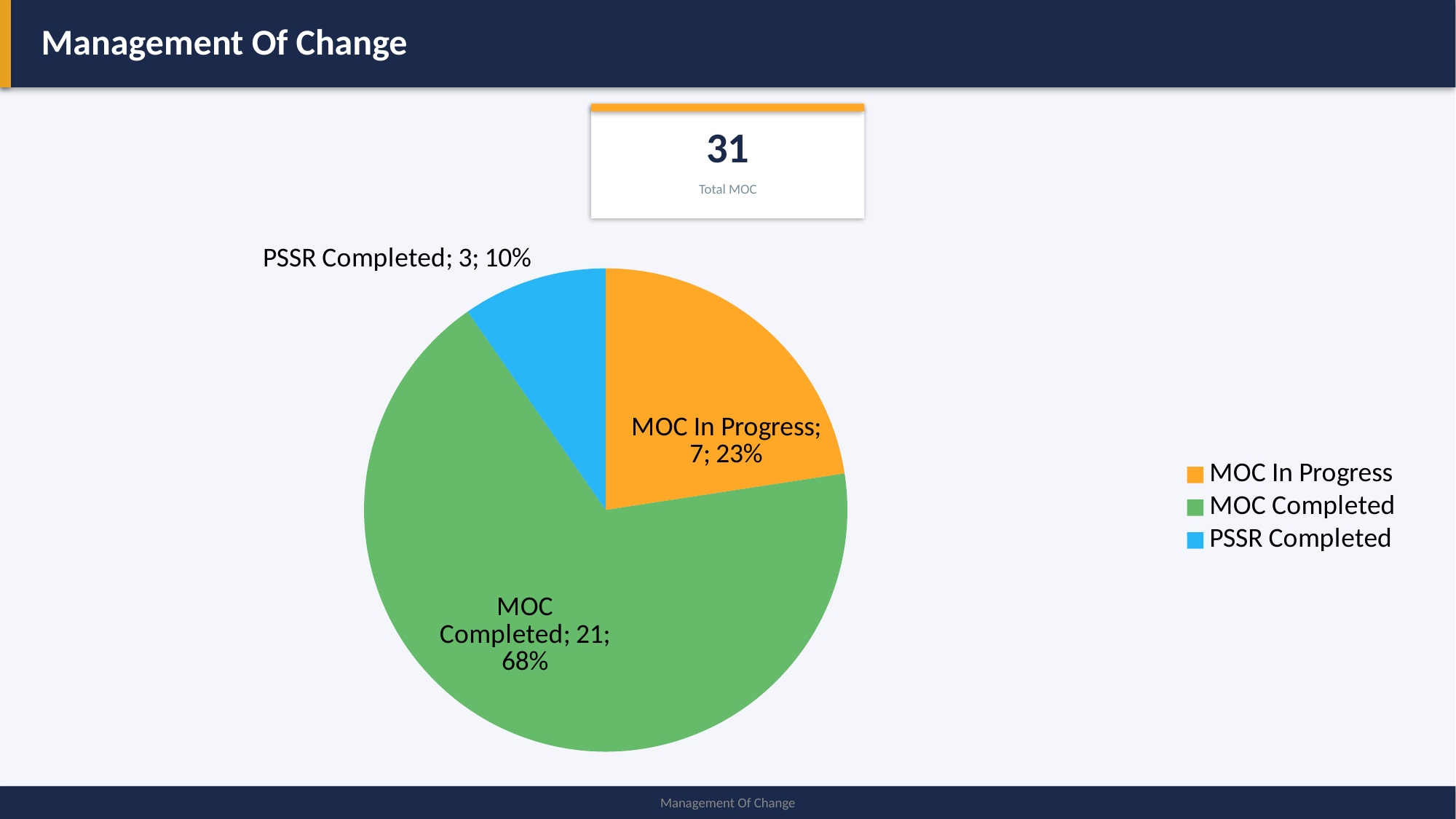
What share of the pie does PSSR Completed represent? 10% Which category has the largest slice? MOC Completed What kind of chart is shown on the slide? pie chart What is the value for MOC Completed? 21 What is the value for MOC In Progress? 7 What is the value for PSSR Completed? 3 What is the difference between the values for MOC Completed and MOC In Progress? 14 What colour is the MOC In Progress slice? orange What share of the pie does MOC Completed represent? 68% How many entries does the legend list? 3 How many slices does the pie chart have? 3 Which category has the smallest slice? PSSR Completed